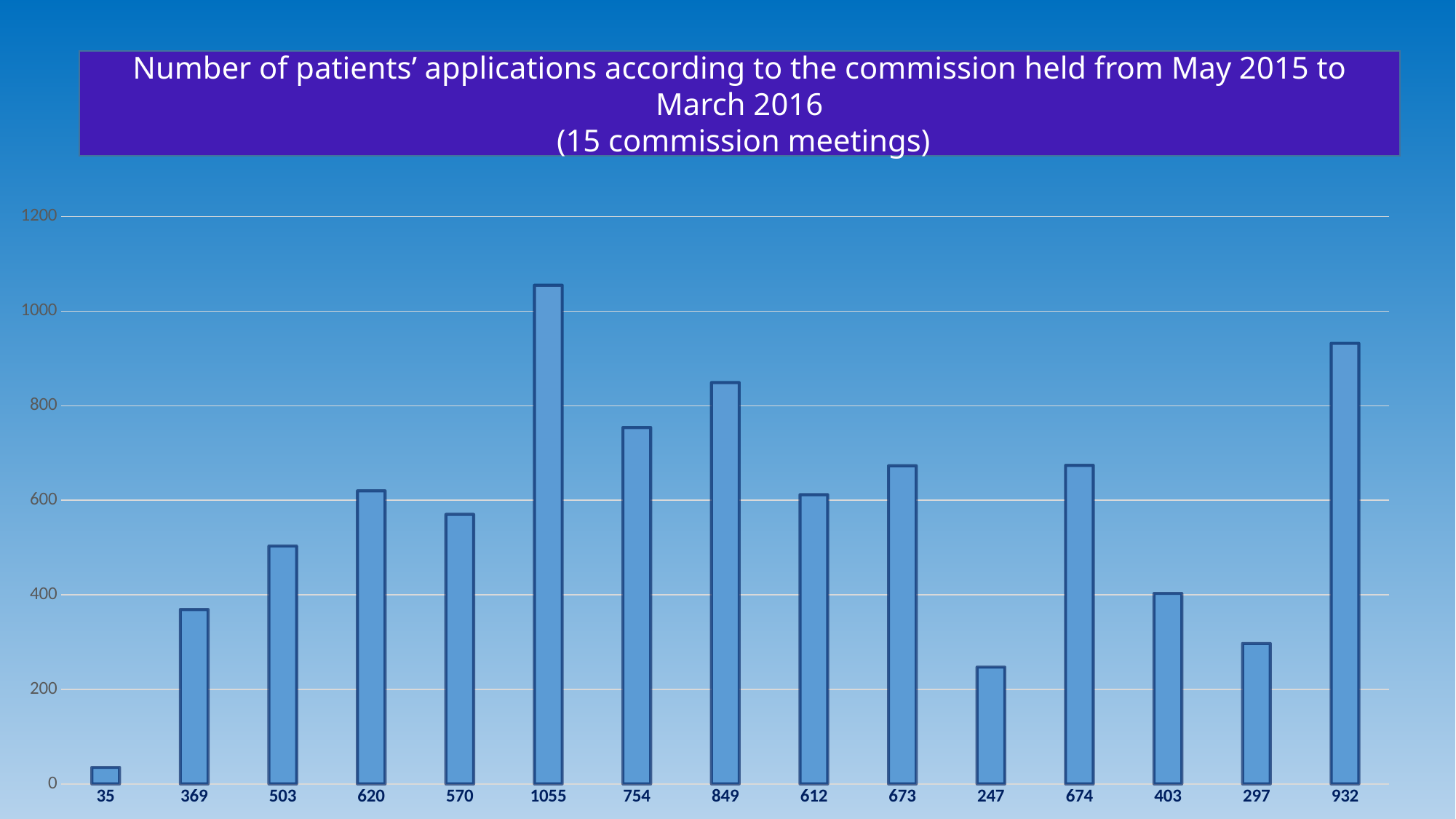
What is the lowest value shown in the chart? 35 What is the highest value shown in the chart? 1055 What is the difference between the highest bar (1055) and the last bar (932)? 123 What is the value of the first bar on the left? 35 What is the value of the last bar on the right? 932 What kind of chart is shown on the slide? bar chart What is the difference between the bar labelled 620 and the bar labelled 570? 50 How many bars (commission meetings) are plotted in the chart? 15 What is the value of the sixth bar from the left? 1055 Which is larger, the bar labelled 849 or the bar labelled 754? 849 What is the title of the chart? Number of patients' applications according to the commission held from May 2015 to March 2016 (15 commission meetings) Is the value of the bar labelled 1055 greater or less than 1000? greater